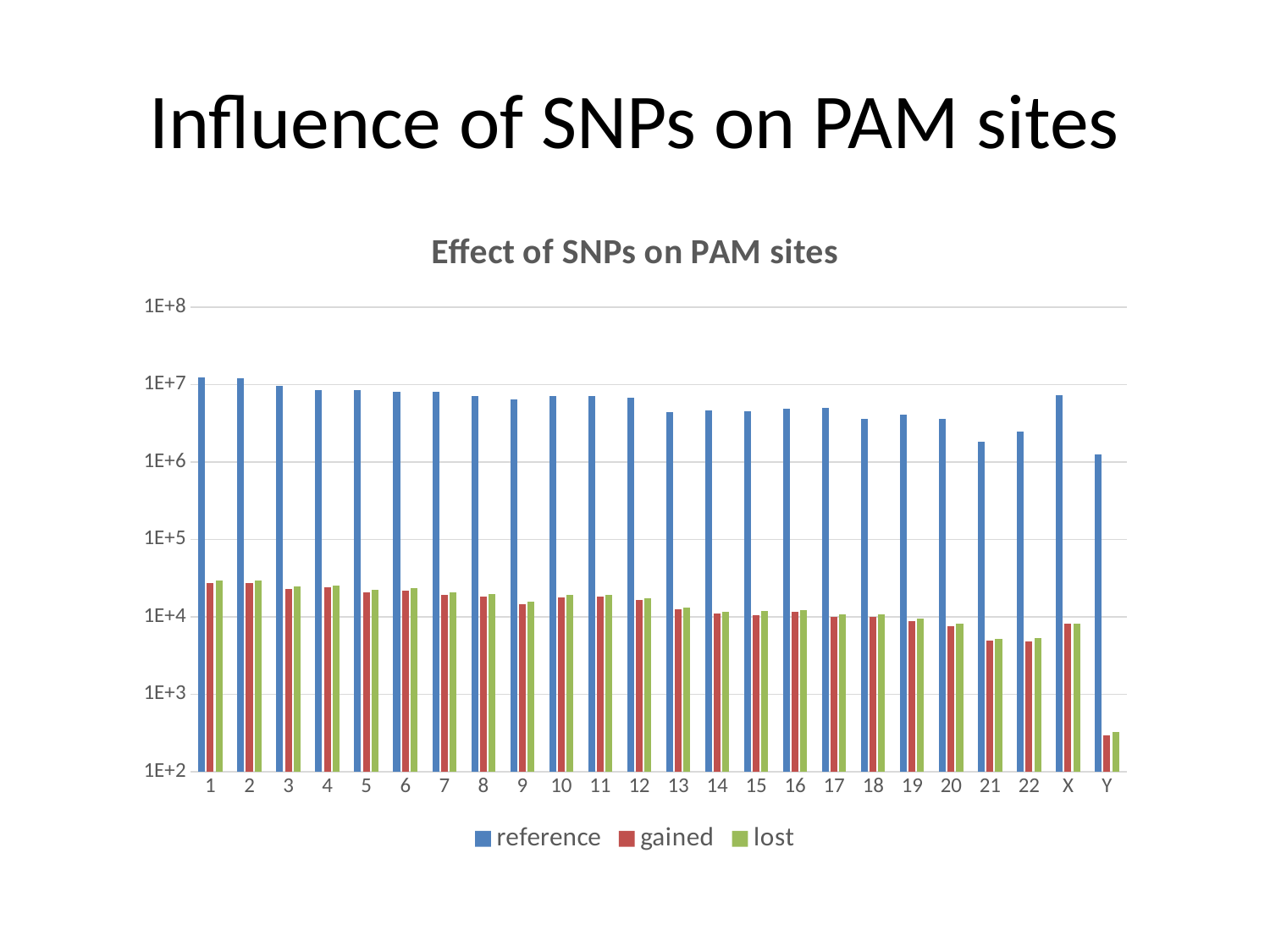
What kind of chart is shown on the slide? bar chart How many series does the legend list? 3 Do the reference values generally rise or fall from category 1 to category 22? fall Is the lost value for category 1 greater or less than 1E+4? greater Is the reference value for category 21 greater or less than 1E+6? greater Which category has the lowest reference value? Y Which is larger for category 5, the reference value or the lost value? reference Which category has the lowest gained value? Y Is the reference value for category 13 greater or less than 1E+7? less How many categories are shown along the x axis? 24 What is the title of the chart? Effect of SNPs on PAM sites